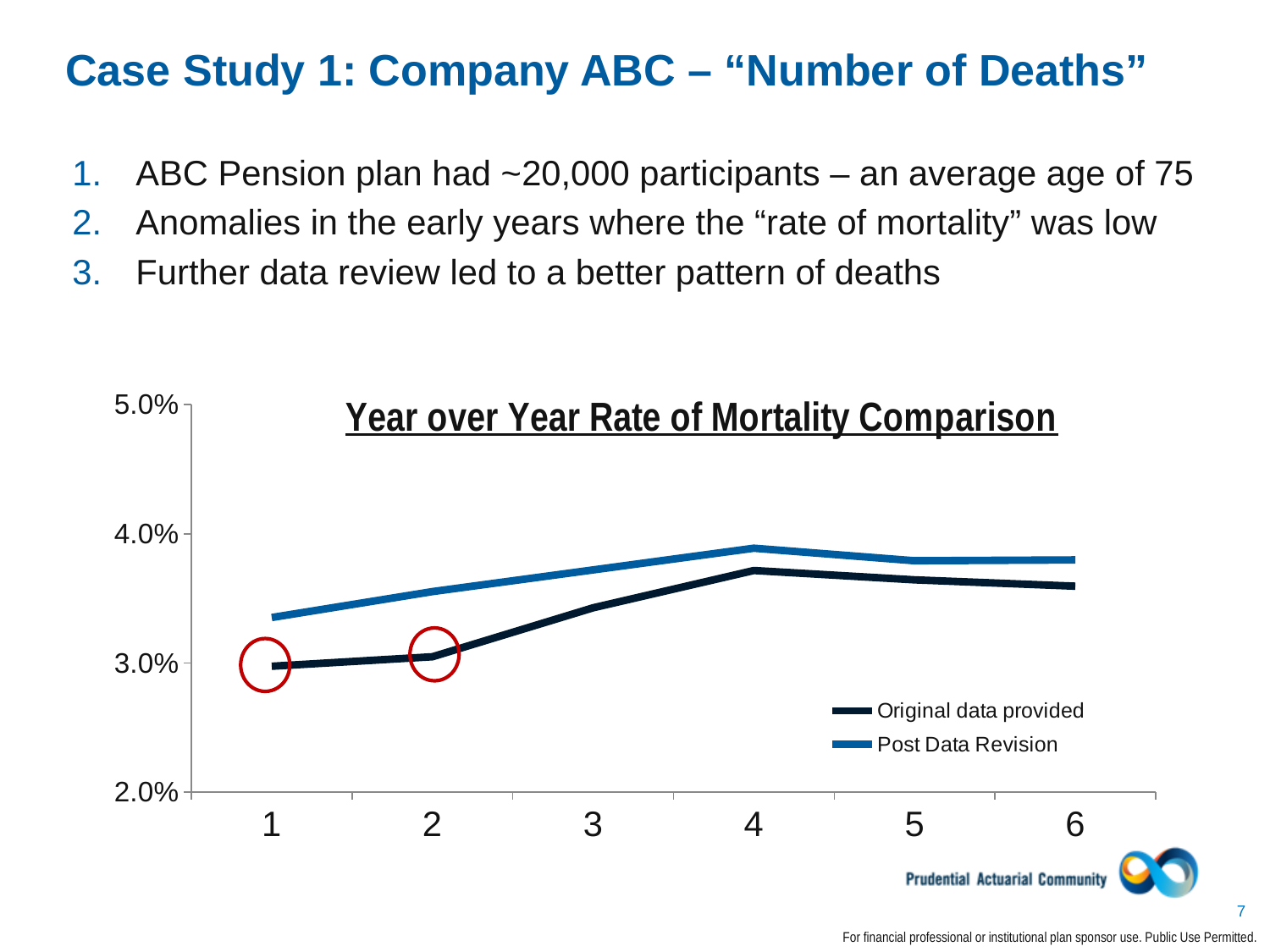
Does the Post Data Revision series rise or fall from year 1 to year 4? Rise At year 1, which series has the larger value, Original data provided or Post Data Revision? Post Data Revision Is the value for Post Data Revision at year 1 greater or less than 3.0%? greater In which year does the Post Data Revision series reach its lowest value? 1 What kind of chart is shown on the slide? Line chart How many series does the chart's legend list? 2 What is the title of the chart? Year over Year Rate of Mortality Comparison Is the value for Original data provided at year 4 greater or less than 4.0%? less In which year does the Original data provided series reach its highest value? 4 How many years (points) are plotted along the x axis? 6 Is the value for Original data provided at year 3 greater or less than 3.0%? greater Which series is plotted with the lighter blue line? Post Data Revision